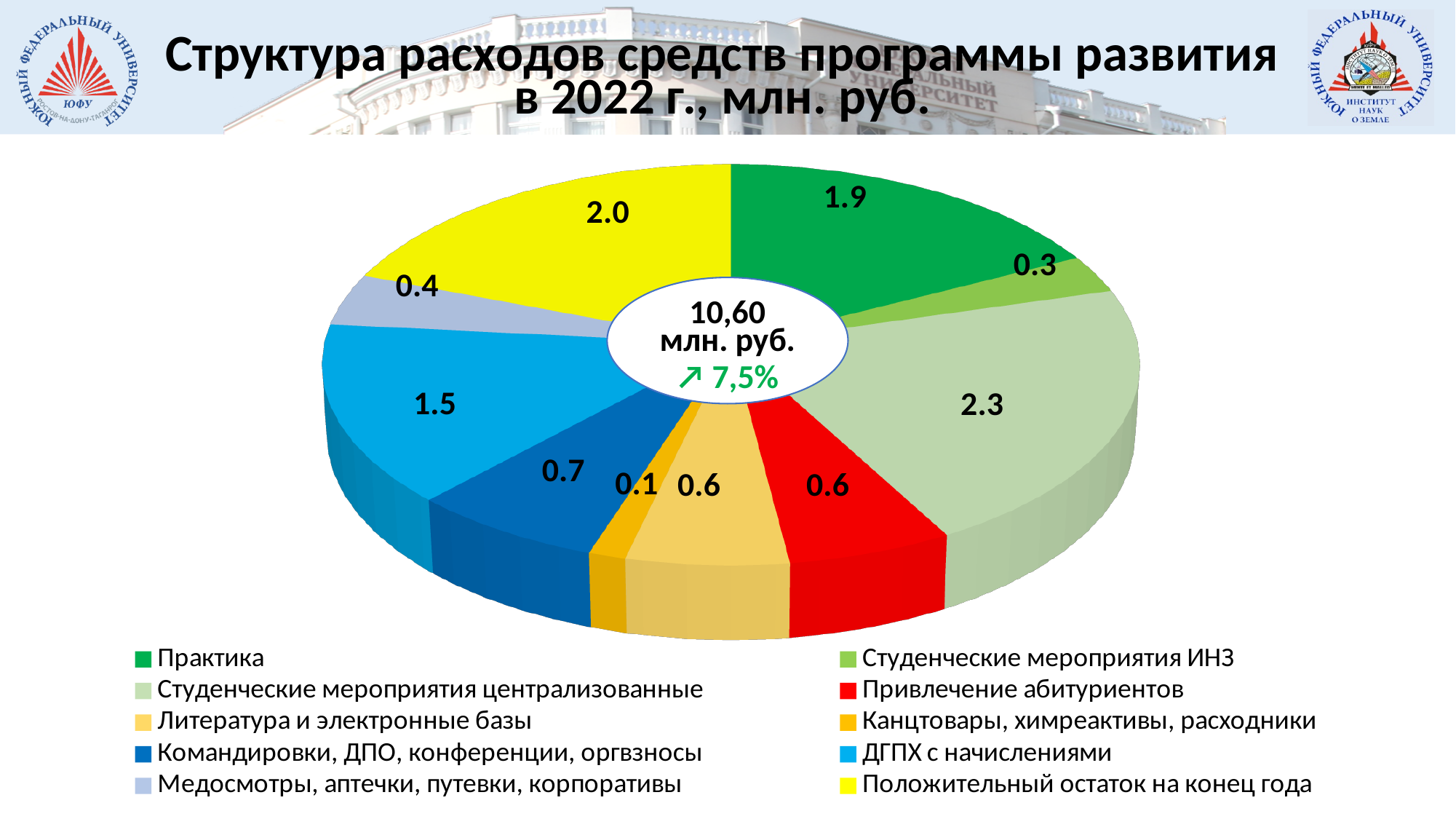
What is the value for Медосмотры, аптечки, путевки, корпоративы? 0.4 What total amount is printed in the centre of the pie chart? 10,60 млн. руб. What is the difference between the values for Студенческие мероприятия централизованные and Студенческие мероприятия ИНЗ? 2.0 How many categories does the pie chart show? 10 What is the value for ДГПХ с начислениями? 1.5 Which category has the smallest value? Канцтовары, химреактивы, расходники What is the difference between the values for Положительный остаток на конец года and Практика? 0.1 What is the value for Практика? 1.9 Which is larger: ДГПХ с начислениями or Командировки, ДПО, конференции, оргвзносы? ДГПХ с начислениями Which category has the largest value? Студенческие мероприятия централизованные What is the value for Положительный остаток на конец года? 2.0 What kind of chart is shown on the slide? pie chart